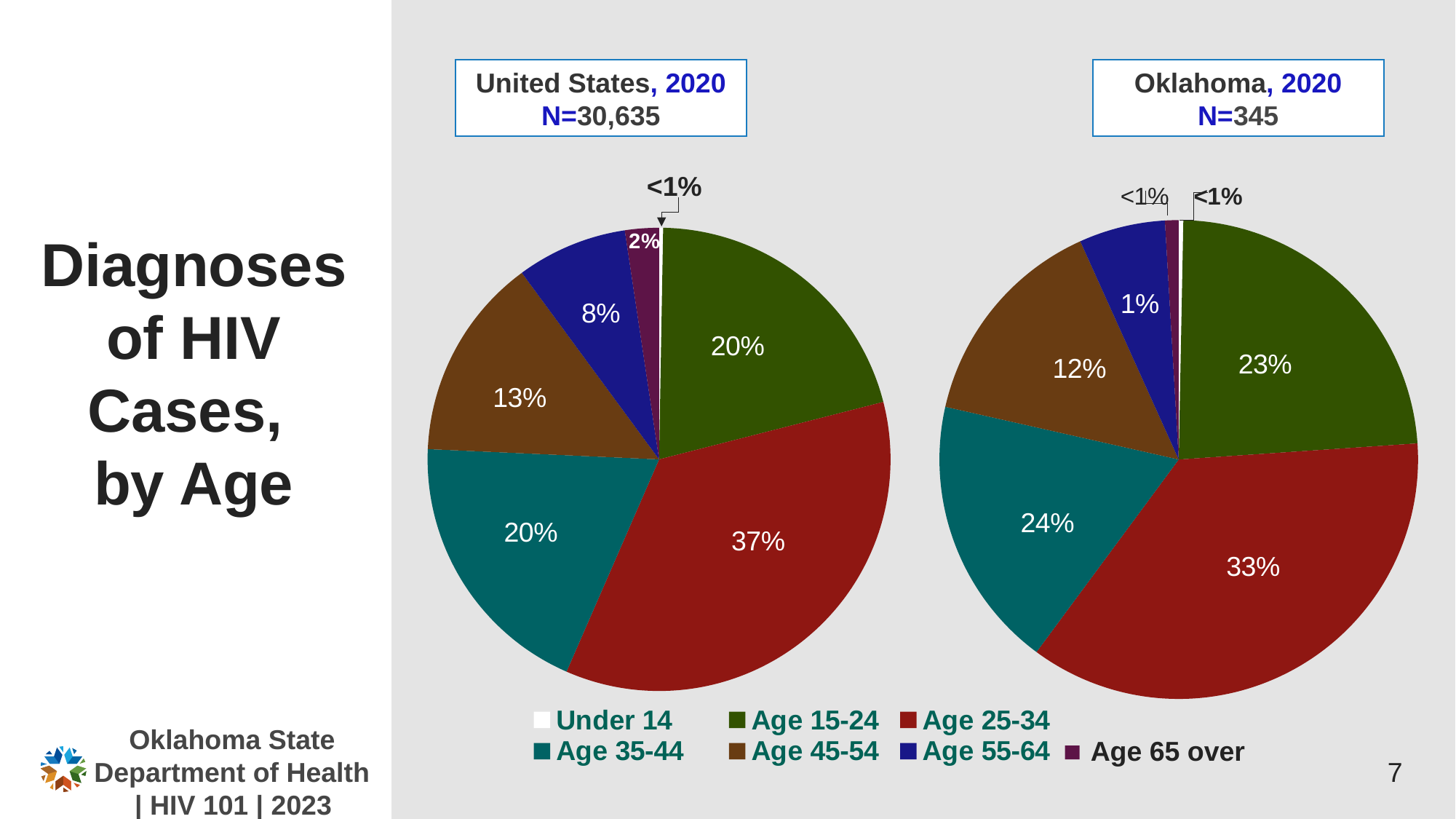
What is the N value shown for the Oklahoma, 2020 chart? N=345 In the Oklahoma, 2020 pie chart, what share is shown for the Age 15-24 group? 23% In the Oklahoma, 2020 pie chart, what share of HIV diagnoses is in the Age 35-44 group? 24% In the United States, 2020 pie chart, what share is shown for the Age 55-64 group? 8% In the Oklahoma, 2020 pie chart, which is larger: the Age 35-44 share or the Age 45-54 share? Age 35-44 In the Oklahoma, 2020 pie chart, what share is shown for the Age 55-64 group? 1% How many age groups does the legend list? 7 In the United States, 2020 pie chart, what share of HIV diagnoses is in the Age 25-34 group? 37% What kind of charts are shown on the slide? Pie charts In the United States, 2020 pie chart, what is the difference between the Age 25-34 share and the Age 45-54 share? 24% In the Oklahoma, 2020 pie chart, which age group has the largest share? Age 25-34 In the United States, 2020 pie chart, which age group has the largest share? Age 25-34